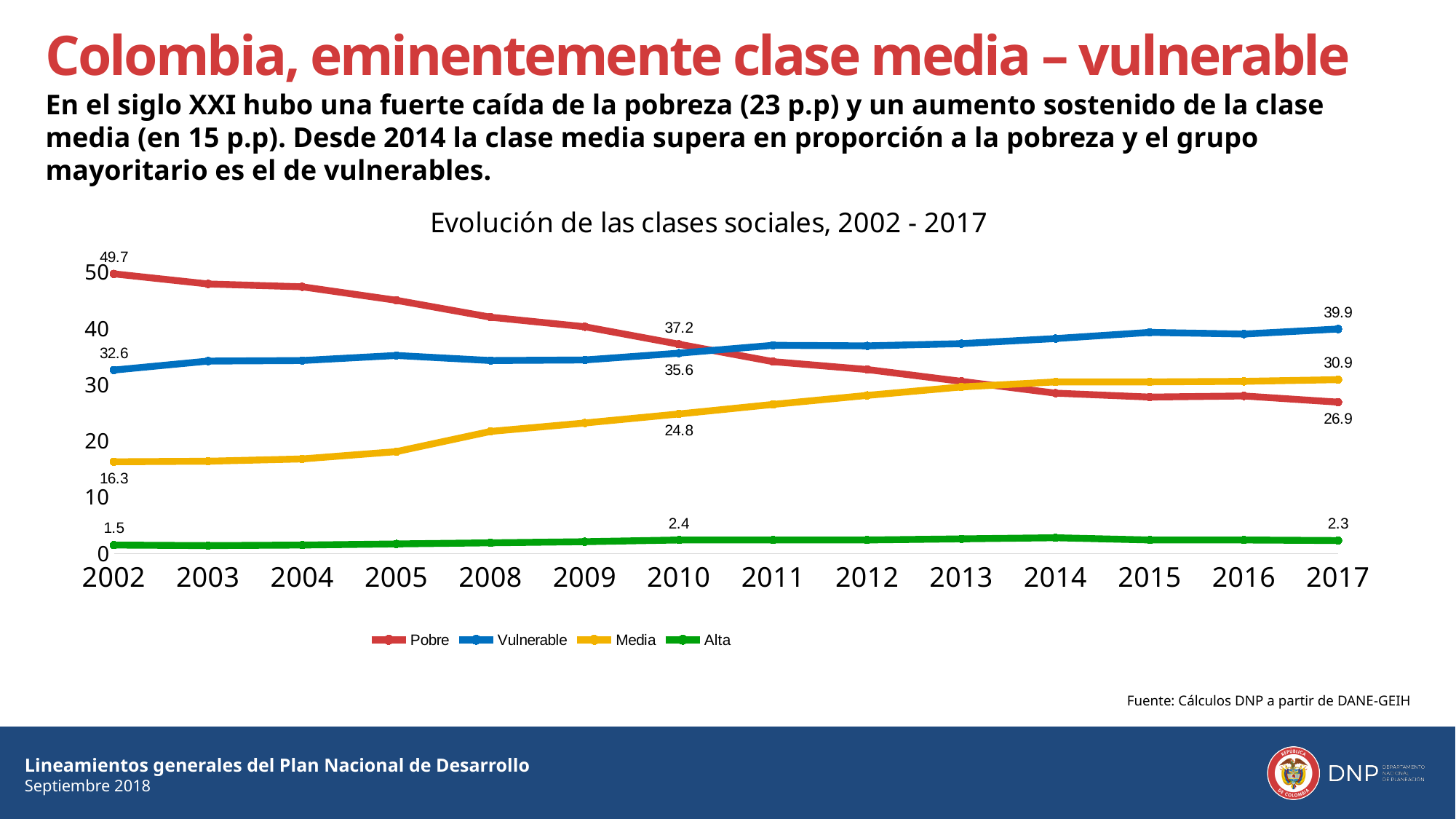
By how much did the Pobre series fall between 2002 and 2017? 22.8 What is the value of the Media series in 2010? 24.8 How many years are shown on the x axis? 14 What is the value of the Alta series in 2002? 1.5 What kind of chart is shown on the slide? Line chart Is the value for the Media series in 2005 greater or less than 20? less What is the value of the Pobre series in 2002? 49.7 Which series has the highest value in 2017? Vulnerable How many series does the legend list? 4 In 2010, which is larger: the Pobre value or the Vulnerable value? Pobre What is the value of the Vulnerable series in 2017? 39.9 Does the Pobre series rise or fall from 2002 to 2017? Fall